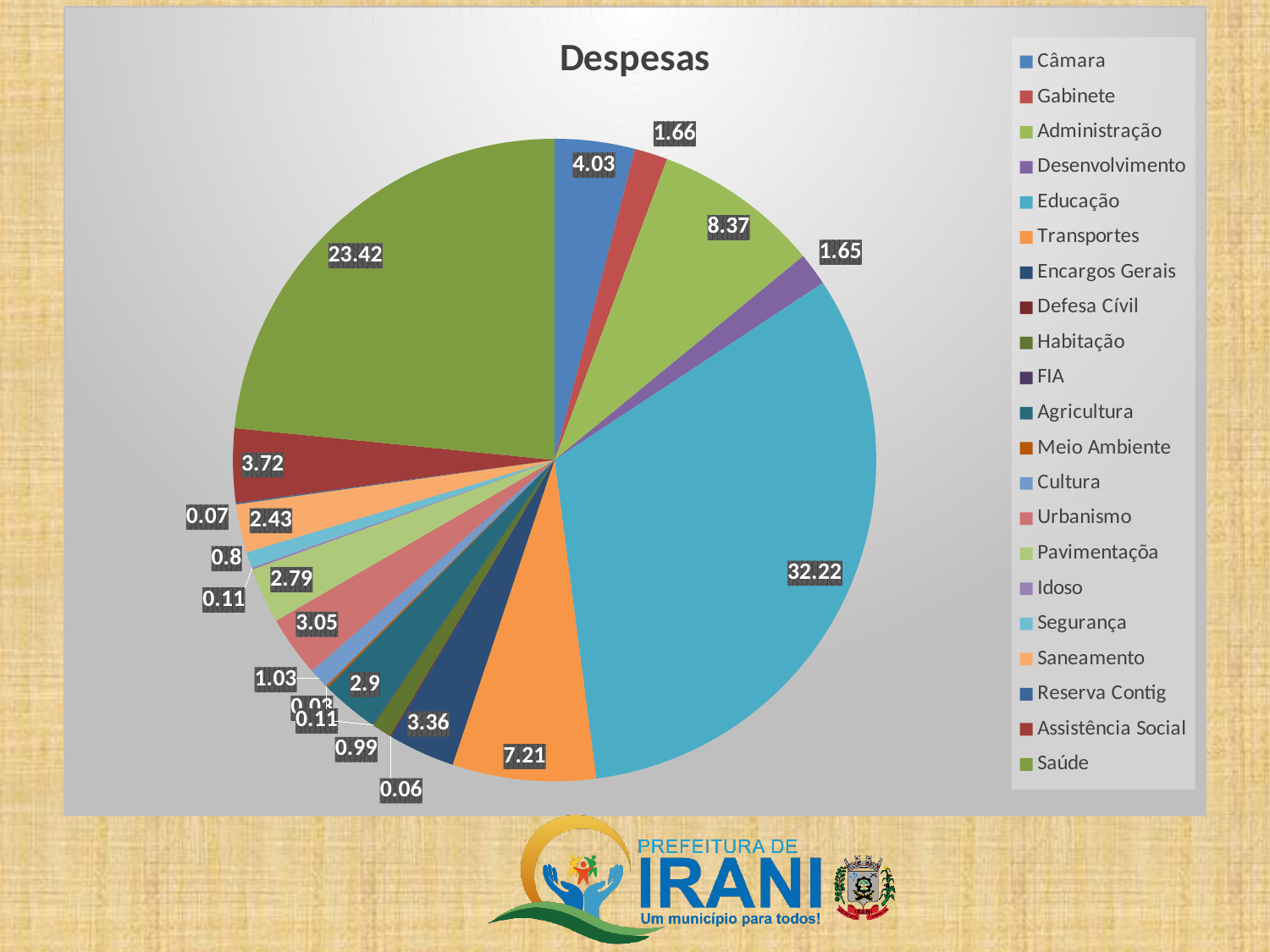
What kind of chart is shown on the slide? pie chart What is the value shown for Saúde? 23.42 How many categories are listed in the legend? 21 Which category has the largest slice of the pie? Educação What is the difference between the values for Administração and Transportes? 1.16 What is the difference between the values for Educação and Saúde? 8.8 What is the value shown for Transportes? 7.21 What is the title of the chart? Despesas What is the value shown for Educação? 32.22 What is the value shown for Administração? 8.37 Which is larger, the value for Administração or the value for Transportes? Administração What is the value shown for Câmara? 4.03